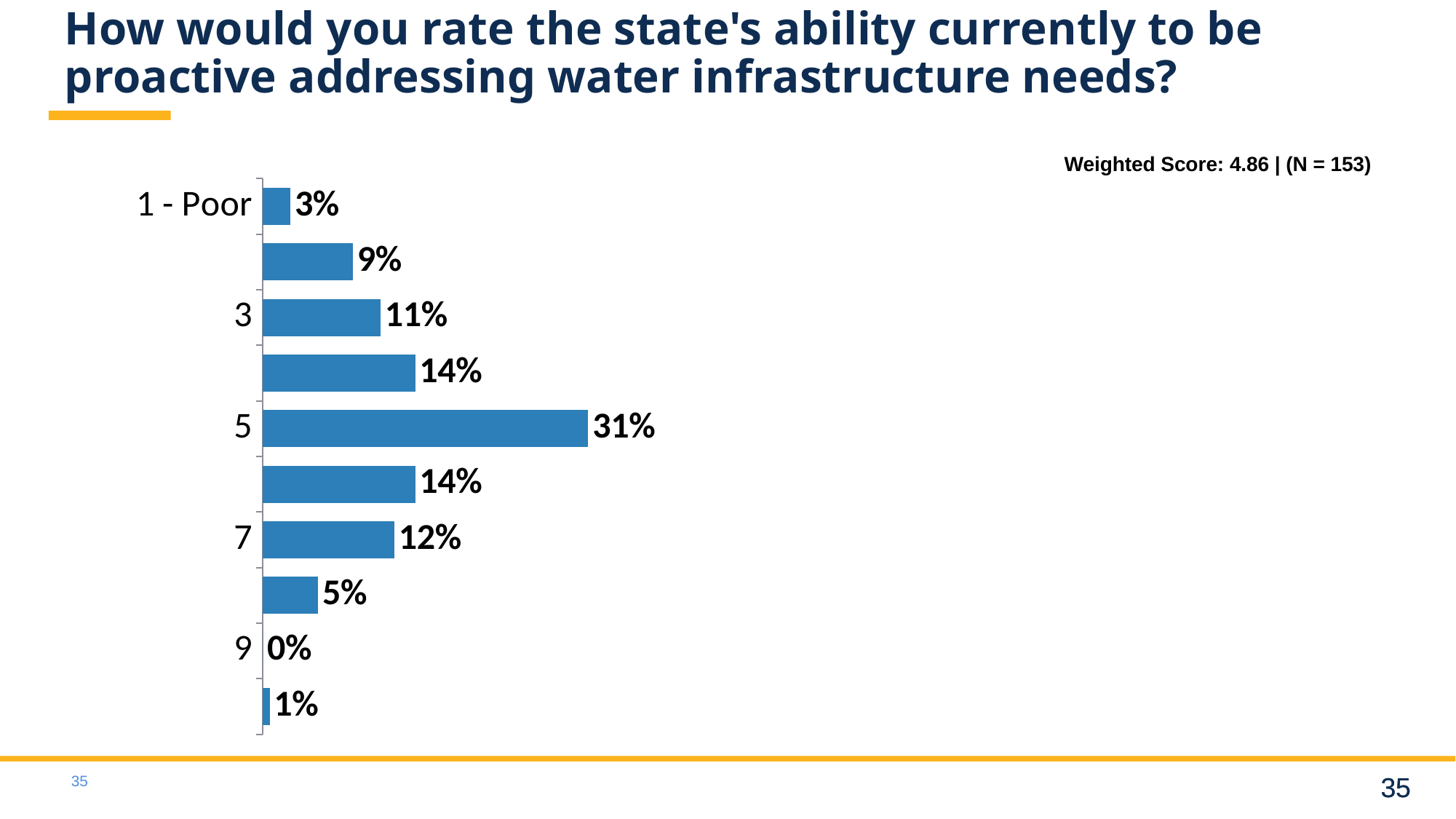
What percentage of respondents gave a rating of 9? 0% Which received a larger share of responses, rating 3 or rating 7? 7 Which rating received the highest percentage of responses? 5 What percentage of respondents rated the state's ability as 1 - Poor? 3% How many bars (rating categories) are shown in the chart? 10 What percentage of respondents gave a rating of 3? 11% What weighted score is reported on the slide? 4.86 How many percentage points higher is the share for rating 5 than for rating 3? 20 Which labeled rating received the lowest percentage of responses? 9 What percentage of respondents gave a rating of 5? 31% What type of chart is shown on the slide? Bar chart What percentage of respondents gave a rating of 7? 12%